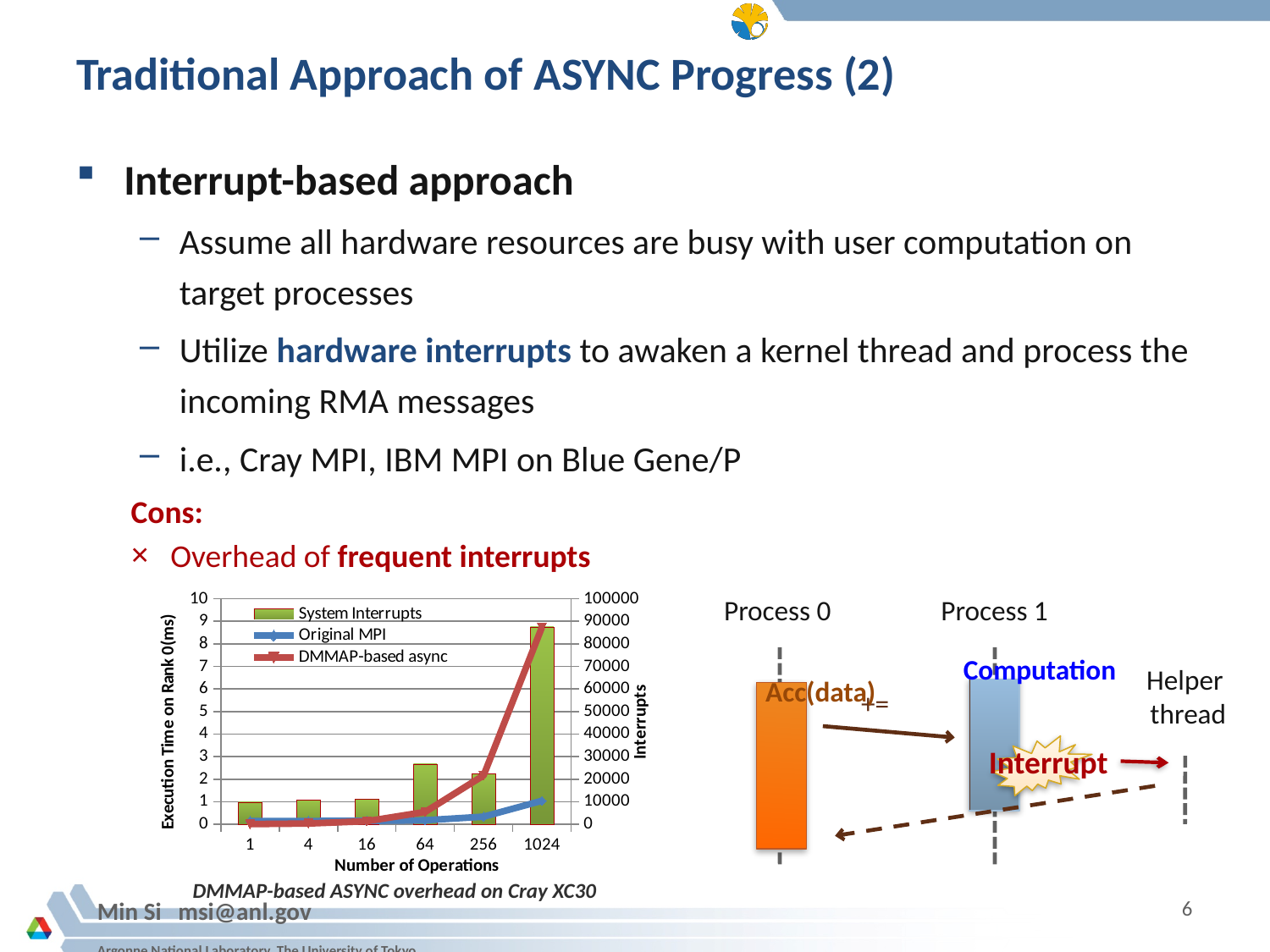
Is the System Interrupts value at 1024 operations greater or less than 80000? greater How many series does the legend of the chart list? 3 Is the System Interrupts value at 64 operations greater or less than 40000? less What is the label of the x axis of the chart? Number of Operations What kind of chart is shown on the slide? A combined bar and line chart How many categories are shown on the x axis of the chart? 6 Is the Original MPI execution time at 1024 operations greater or less than 2 ms? less Does the DMMAP-based async line rise or fall as the number of operations increases? Rises At 1024 operations, which has the larger execution time: Original MPI or DMMAP-based async? DMMAP-based async For which number of operations is the System Interrupts bar highest? 1024 What is the caption below the chart? DMMAP-based ASYNC overhead on Cray XC30